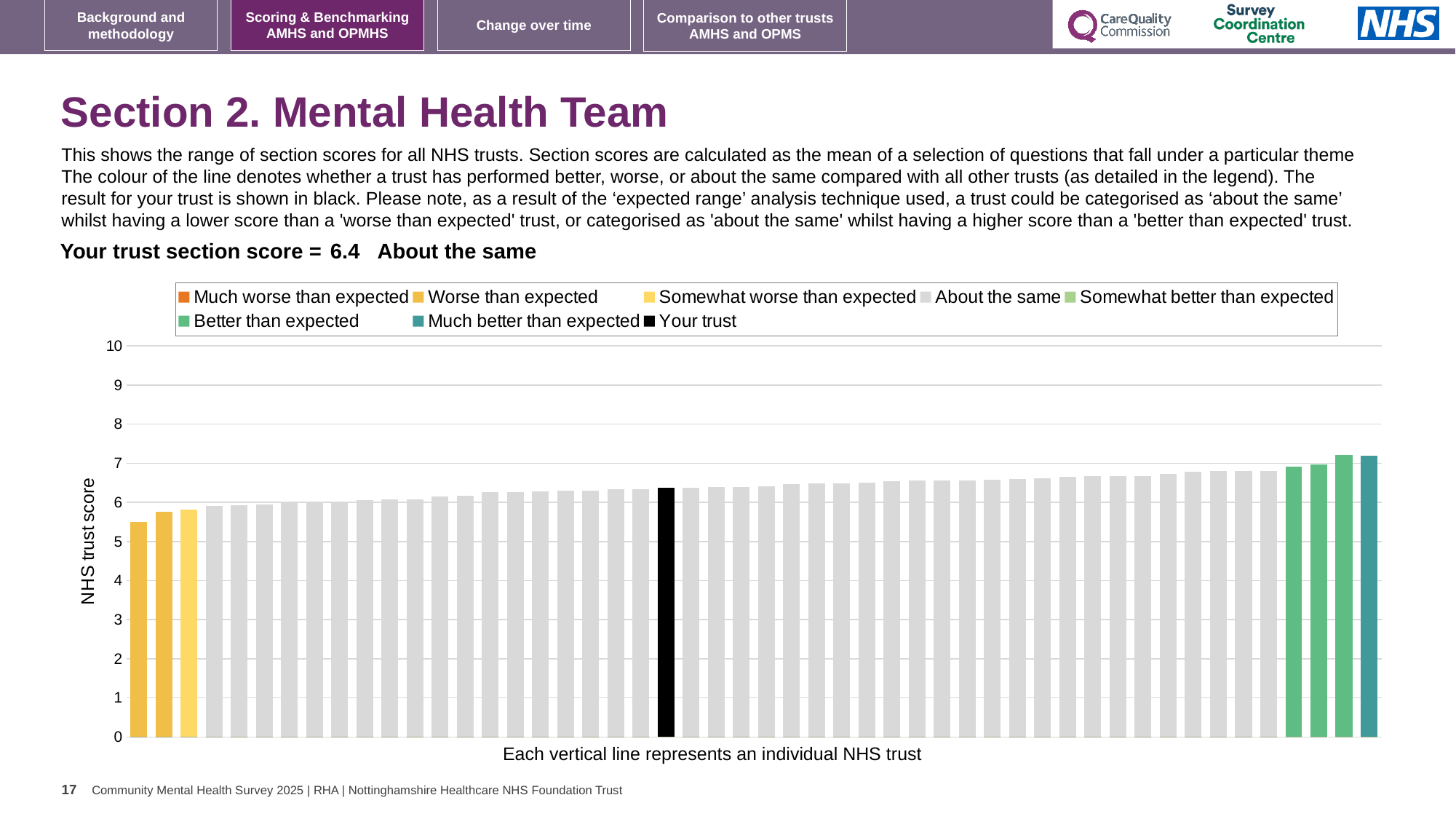
Do the bar values rise or fall from left to right along the x axis? rise Is the value of the lowest bar in the chart greater or less than 6? less What is the section score for your trust shown on the slide? 6.4 Which category is your trust placed in according to the text above the chart? About the same Is the value of the highest bar in the chart greater or less than 8? less What type of chart is shown on the slide? bar chart Is the value for your trust (the black bar) greater or less than 6? greater How many entries does the chart legend list? 8 What colour is the bar representing your trust? black What is the title of the vertical axis? NHS trust score